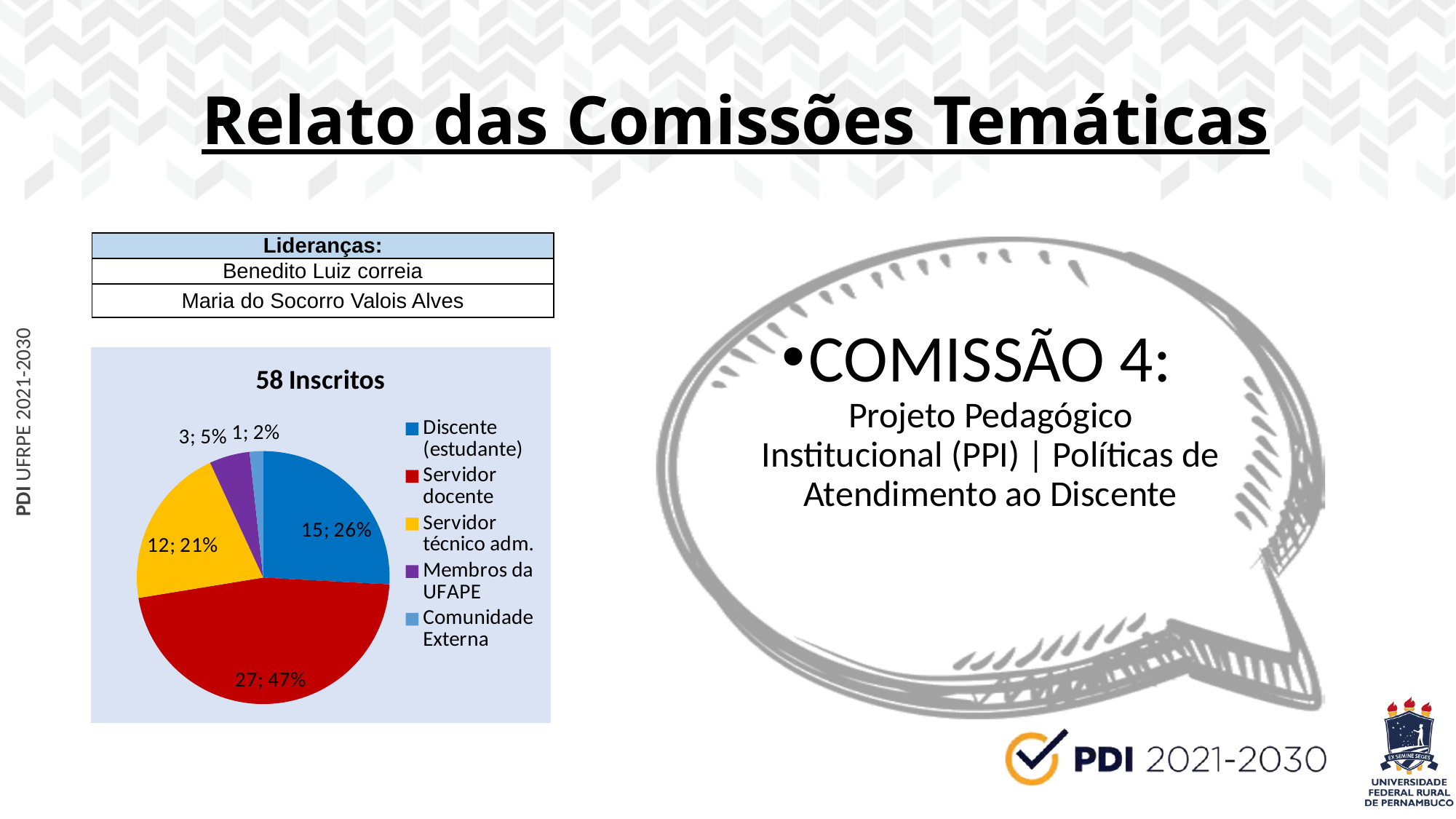
Which category has the smallest slice in the pie chart? Comunidade Externa What is the count shown for Servidor técnico adm. in the pie chart? 12 What percentage of the pie does Membros da UFAPE represent? 5% What type of chart is shown on the slide? Pie chart What is the title of the pie chart? 58 Inscritos Which is larger in the pie chart: Servidor técnico adm. or Membros da UFAPE? Servidor técnico adm. Which category has the largest slice in the pie chart? Servidor docente What is the difference between the counts for Servidor docente and Discente (estudante)? 12 What percentage of the pie does Discente (estudante) represent? 26% What is the count shown for Servidor docente in the pie chart? 27 How many entries does the legend of the pie chart list? 5 How many slices does the pie chart have? 5